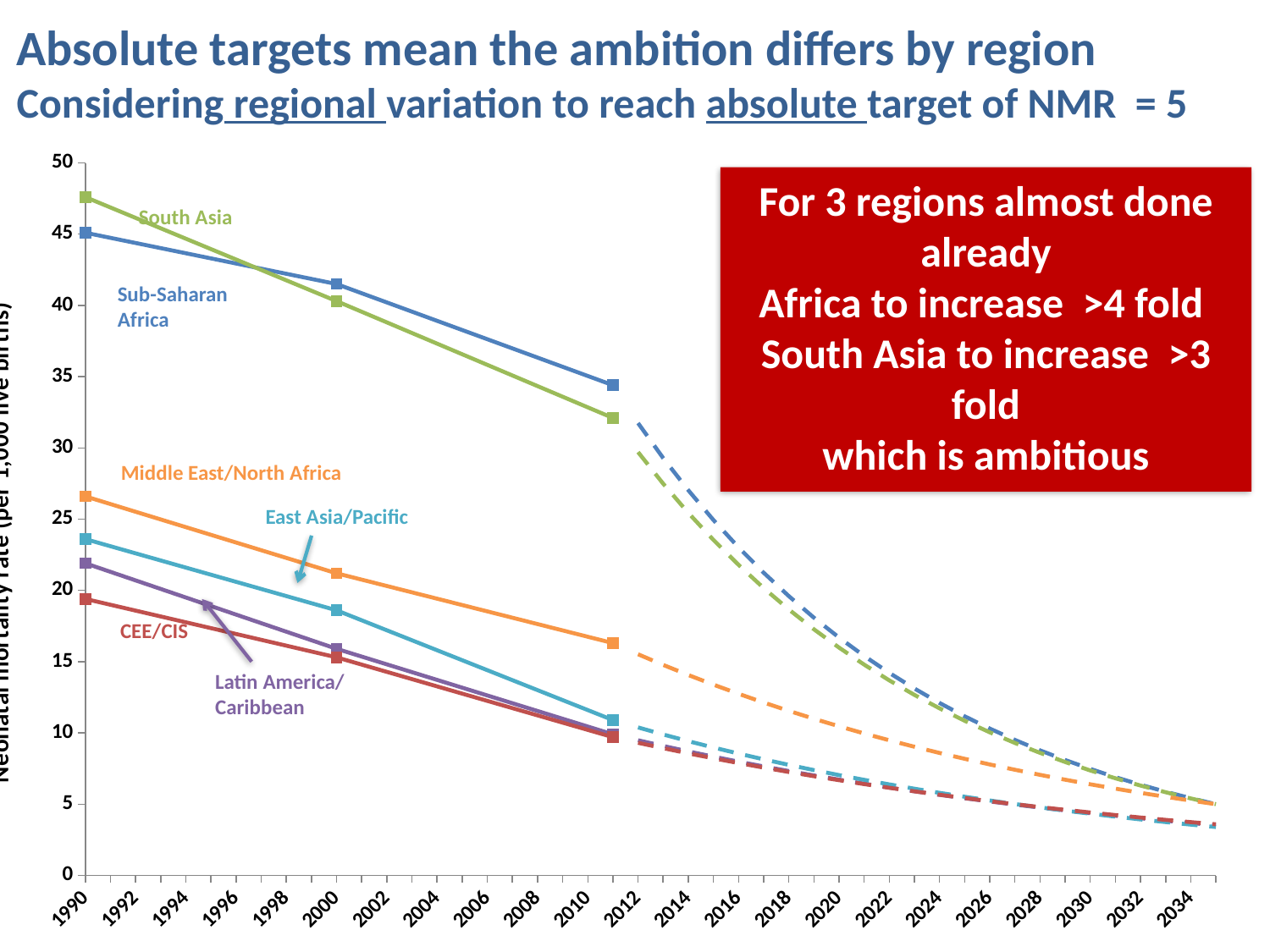
How many regions are plotted as lines on the chart? 6 Which region has the highest neonatal mortality rate in 1990? South Asia What kind of chart is shown on the slide? line chart What absolute NMR target does the slide subtitle say the regions are to reach? 5 Is the value for Middle East/North Africa in 1990 greater or less than 25? greater Is the value for South Asia in 2010 greater or less than 30? greater Which region has the highest neonatal mortality rate in 2010? Sub-Saharan Africa Which region has the lowest neonatal mortality rate in 1990? CEE/CIS Is the value for CEE/CIS in 1990 greater or less than 20? less In 2000, which is higher: Middle East/North Africa or East Asia/Pacific? Middle East/North Africa Do the neonatal mortality rates rise or fall from 1990 to 2010 for all regions? fall